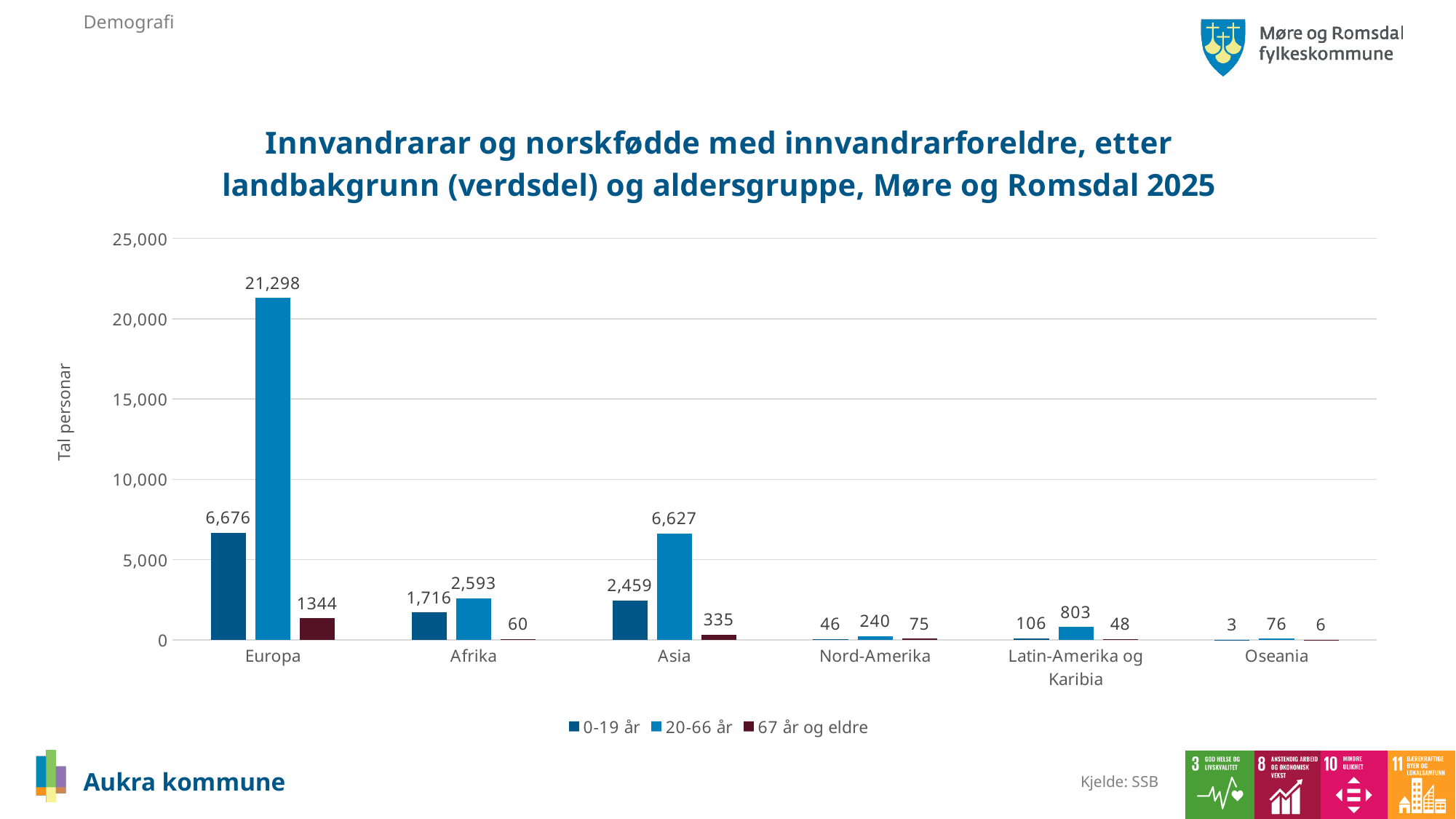
Which region has the highest value in the 20-66 år series? Europa How many series does the legend list? 3 What kind of chart is shown on the slide? Bar chart Which is larger: the 0-19 år value for Europa or the 20-66 år value for Asia? 0-19 år value for Europa How many regions (categories) are shown on the x axis? 6 Which region has the lowest value in the 0-19 år series? Oseania What is the value for the 67 år og eldre series for Asia? 335 What is the value for the 20-66 år series for Europa? 21,298 Is the 20-66 år value for Europa greater or less than 20,000? greater What is the value for the 0-19 år series for Latin-Amerika og Karibia? 106 What is the label of the y axis? Tal personar What is the difference between the 20-66 år values for Asia and Afrika? 4,034